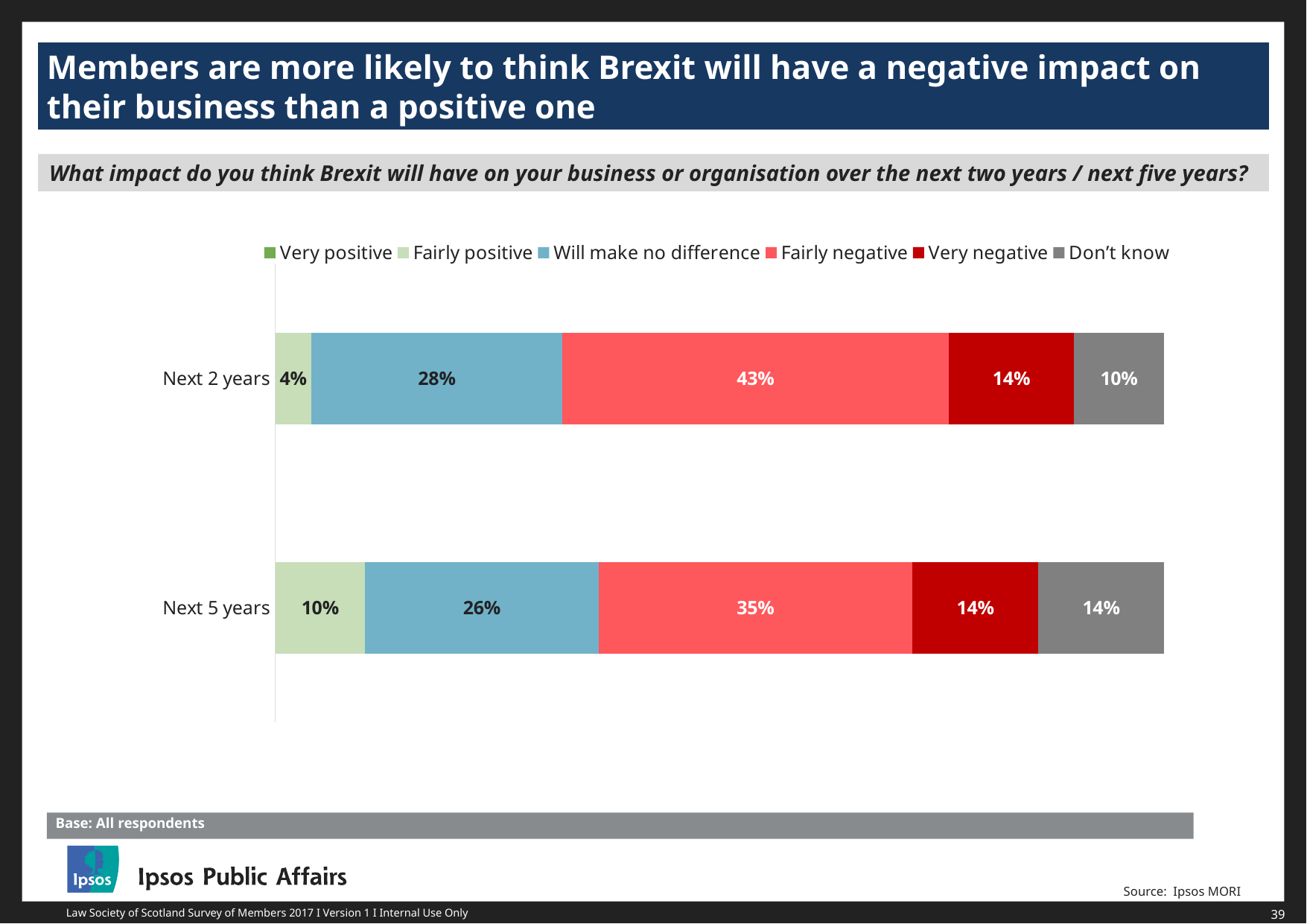
What percentage of members think Brexit will have a fairly positive impact over the next 5 years? 10% What is the 'Very negative' value for the Next 2 years bar? 14% How many response categories does the legend list? 6 Which response category has the largest share in the Next 2 years bar? Fairly negative By how many percentage points does the 'Fairly negative' share for Next 2 years exceed that for Next 5 years? 8 percentage points What is the 'Don't know' value for the Next 5 years bar? 14% What percentage of members think Brexit will have a fairly negative impact on their business over the next 2 years? 43% What is the difference between the 'Will make no difference' values for Next 2 years and Next 5 years? 2 percentage points How many time periods (bars) are shown in the chart? 2 Which time period has the larger 'Fairly positive' share, Next 2 years or Next 5 years? Next 5 years What type of chart is used on this slide? Stacked bar chart What is the value for 'Will make no difference' in the Next 2 years bar? 28%